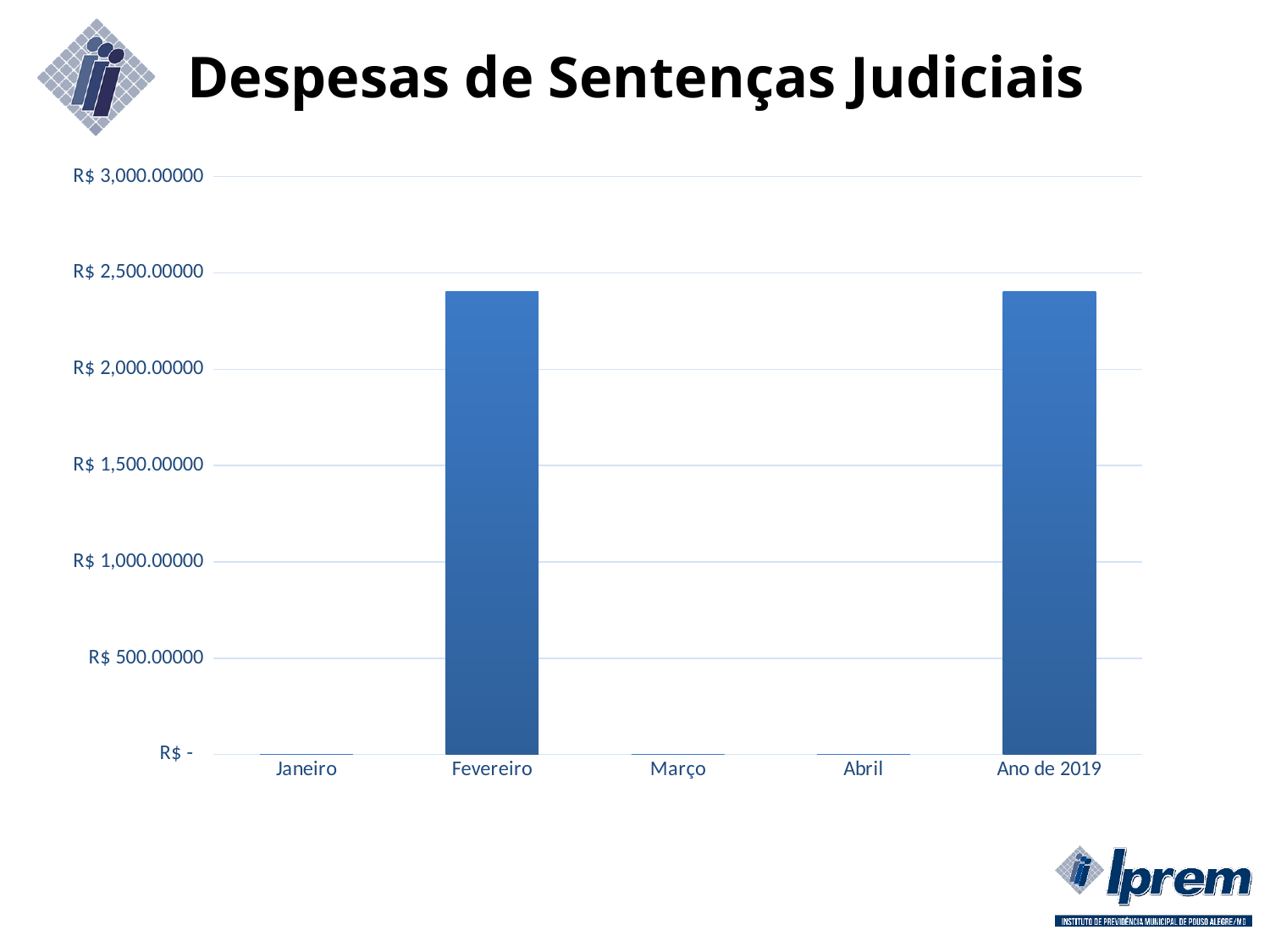
Which is larger, the value for Fevereiro or the value for Março? Fevereiro Is the value for Abril greater or less than R$ 500.00000? less What is the title of the chart? Despesas de Sentenças Judiciais Is the value for Janeiro greater or less than R$ 500.00000? less Is the value for Fevereiro greater or less than R$ 2,000.00000? greater What kind of chart is shown on the slide? bar chart How many categories are shown on the x axis of the chart? 5 What is the label of the last category on the x axis? Ano de 2019 Which is larger, the value for Janeiro or the value for Ano de 2019? Ano de 2019